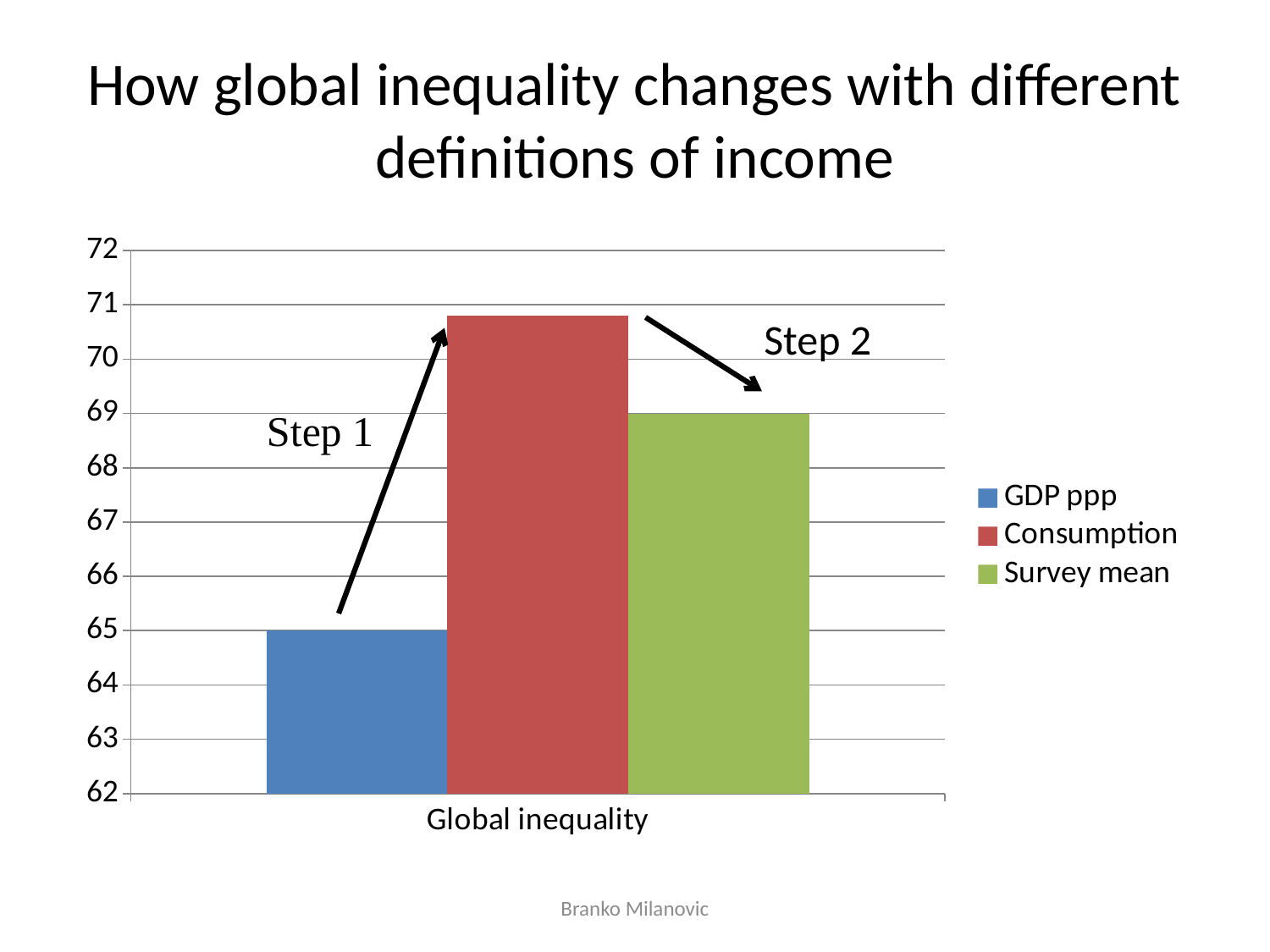
Which is larger, the Survey mean bar or the GDP ppp bar? Survey mean What kind of chart is shown on the slide? bar chart What is the value of the Survey mean bar? 69 Which series has the highest value for Global inequality? Consumption Is the value for Consumption greater or less than 71? less Which series has the lowest value for Global inequality? GDP ppp How many series does the legend list? 3 How many categories are shown on the x axis? 1 Is the value for Consumption greater or less than 70? greater What colour is the Consumption bar? red What is the value of the GDP ppp bar? 65 What is the difference between the Survey mean value and the GDP ppp value? 4